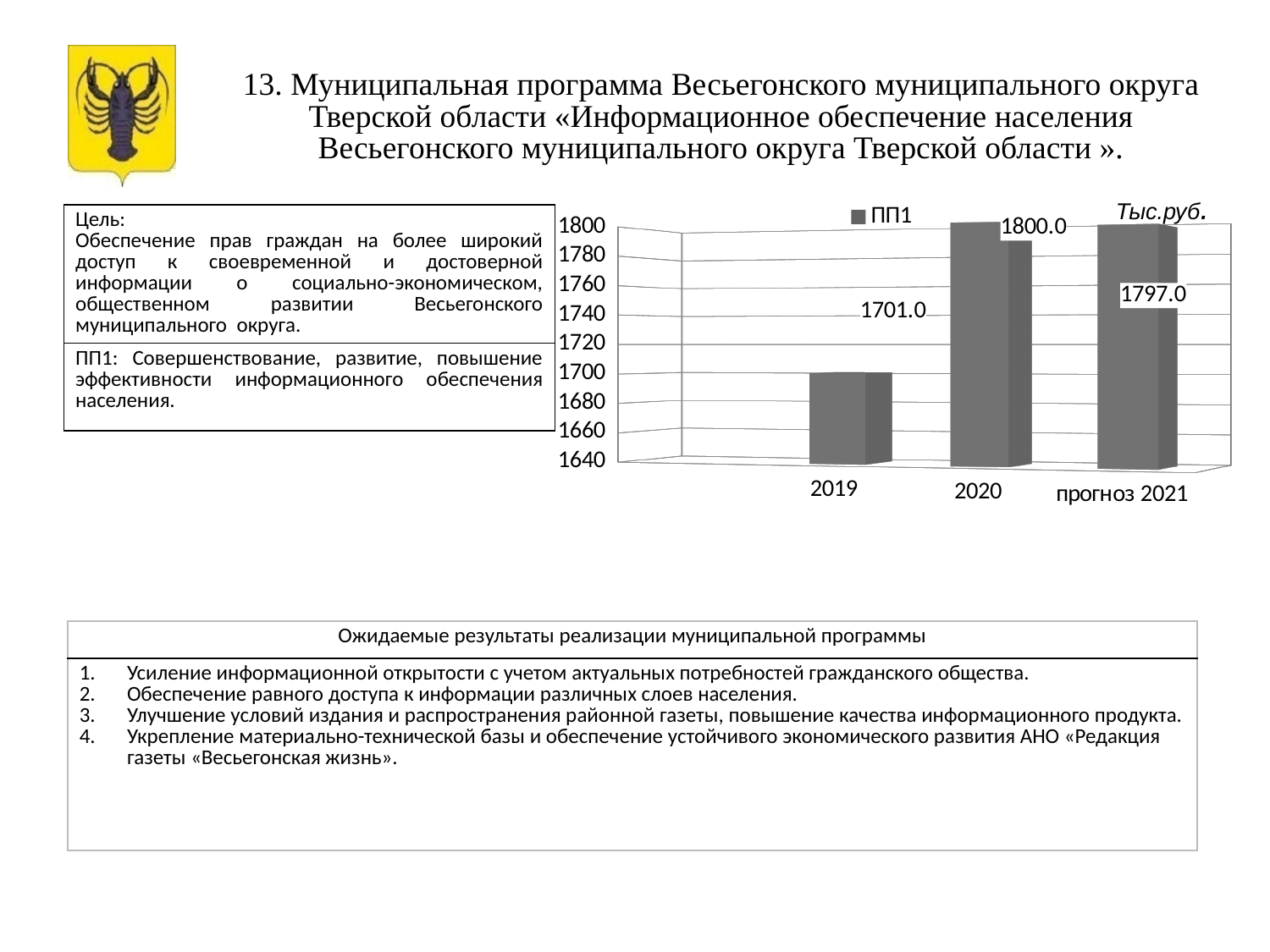
How many categories are shown on the x axis of the chart? 3 How many series does the chart legend list? 1 Which category has the lowest value in the chart? 2019 What is the difference between the values for 2020 and 2019? 99.0 Which category has the highest value in the chart? 2020 What kind of chart is shown on the slide? bar chart Is the value for 2019 greater or less than 1720? less What is the value for прогноз 2021 in the chart? 1797.0 What is the value for 2019 in the chart? 1701.0 Which is larger, the value for 2019 or the value for прогноз 2021? прогноз 2021 What is the value for 2020 in the chart? 1800.0 What is the difference between the values for 2020 and прогноз 2021? 3.0